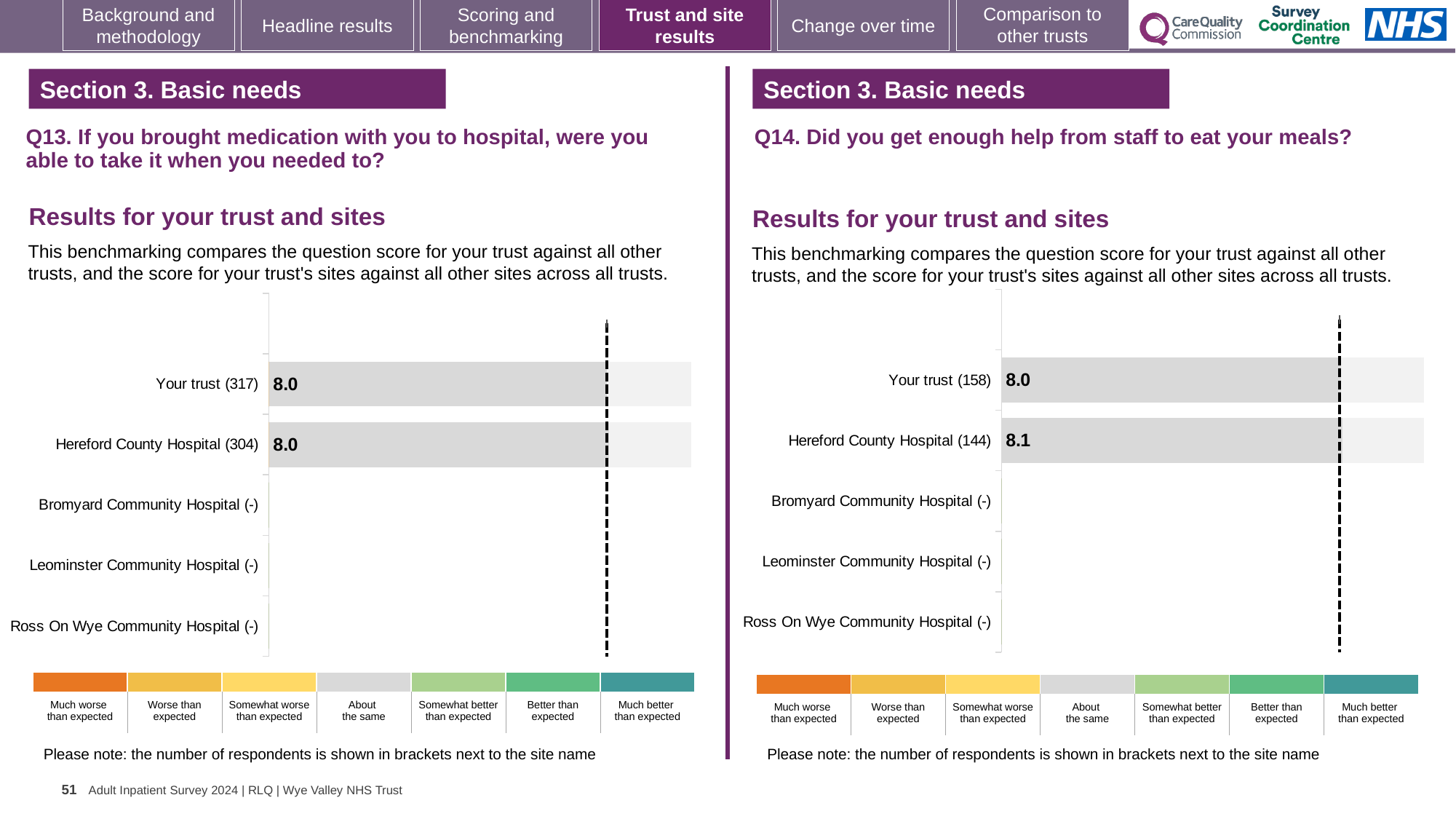
In the Q14 chart on the right, how many respondents are shown in brackets for Hereford County Hospital? 144 In the Q14 chart on the right, what is the score for Your trust? 8.0 In the Q14 chart on the right, what is the difference between the Hereford County Hospital score and the Your trust score? 0.1 How many sites or categories are listed on the y axis of the Q13 chart on the left? 5 In the Q13 chart on the left, what is the score for Hereford County Hospital? 8.0 In the Q13 chart on the left, how many respondents are shown in brackets for Your trust? 317 In the Q14 chart on the right, which has the higher score, Your trust or Hereford County Hospital? Hereford County Hospital In the Q14 chart on the right, what is the score for Hereford County Hospital? 8.1 What kind of chart is the Q13 chart on the left? Bar chart How many sites or categories are listed on the y axis of the Q14 chart on the right? 5 How many colour bands does the legend below the Q14 chart on the right show? 7 In the Q13 chart on the left, what is the score for Your trust? 8.0